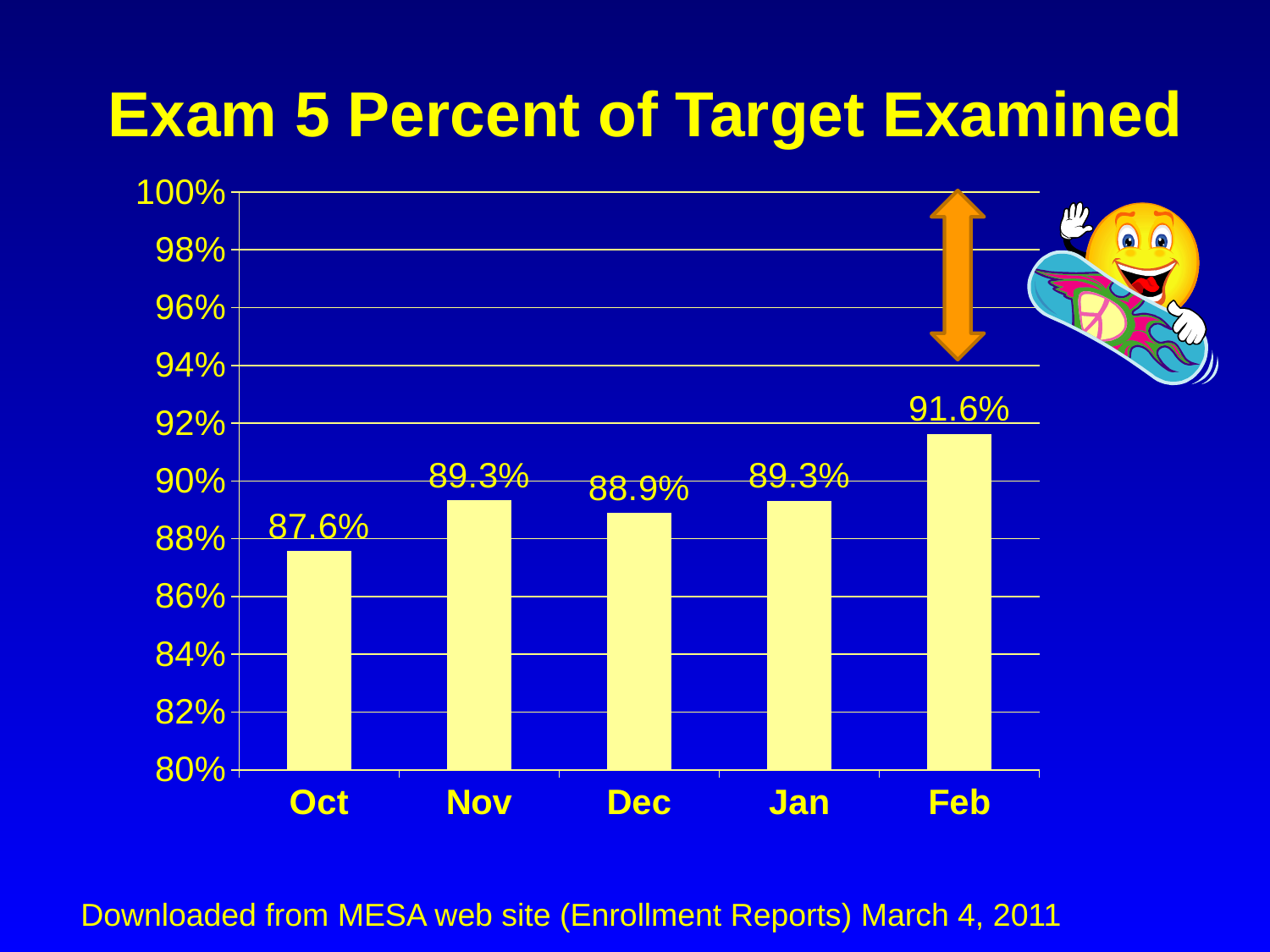
What is the value for Dec? 88.9% What kind of chart is shown on the slide? bar chart Which month has the highest percent of target examined? Feb What is the title of the chart? Exam 5 Percent of Target Examined What is the highest value shown on the y axis? 100% What is the value for Oct? 87.6% How many months are shown on the x axis? 5 What is the value for Feb? 91.6% What is the difference between the values for Feb and Oct? 4.0% Which is larger, the value for Nov or the value for Dec? Nov Is the value for Jan greater or less than 90%? less Which month has the lowest percent of target examined? Oct